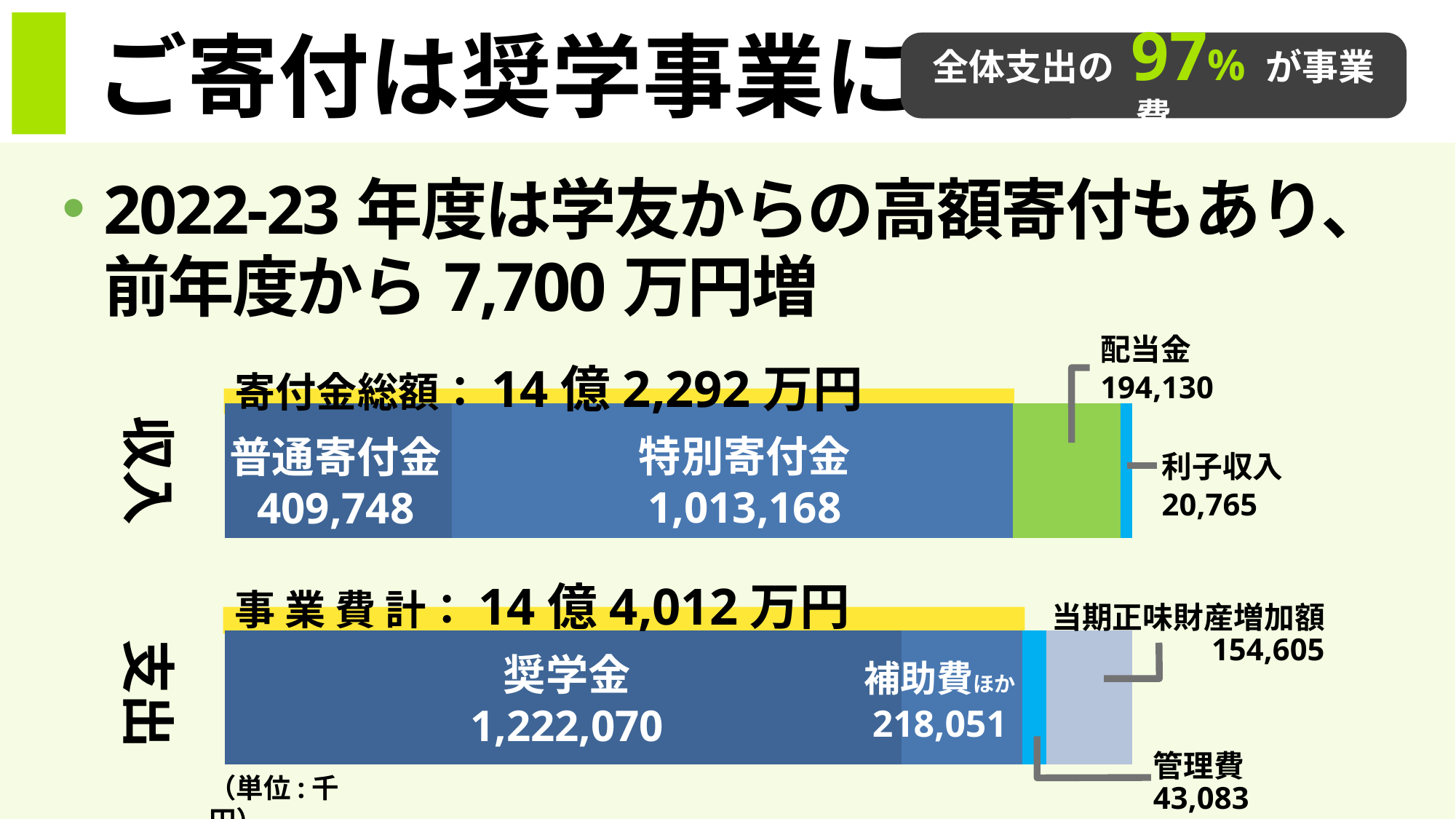
In the 収入 bar, which segment has the largest value? 特別寄付金 In the 収入 bar, what is the difference between 特別寄付金 and 普通寄付金? 603,420 In the 支出 bar, which is larger, 当期正味財産増加額 or 管理費? 当期正味財産増加額 How many segments make up the 支出 bar? 4 In the 収入 bar, which segment has the smallest value? 利子収入 In the 収入 bar, what is the value for 普通寄付金? 409,748 In the 収入 bar, what is the value for 特別寄付金? 1,013,168 In the 支出 bar, what is the value for 奨学金? 1,222,070 In the 支出 bar, what is the difference between 奨学金 and 補助費ほか? 1,004,019 In the 支出 bar, what is the value for 管理費? 43,083 In the 支出 bar, which segment has the smallest value? 管理費 What kind of chart is shown on the slide? Stacked bar chart